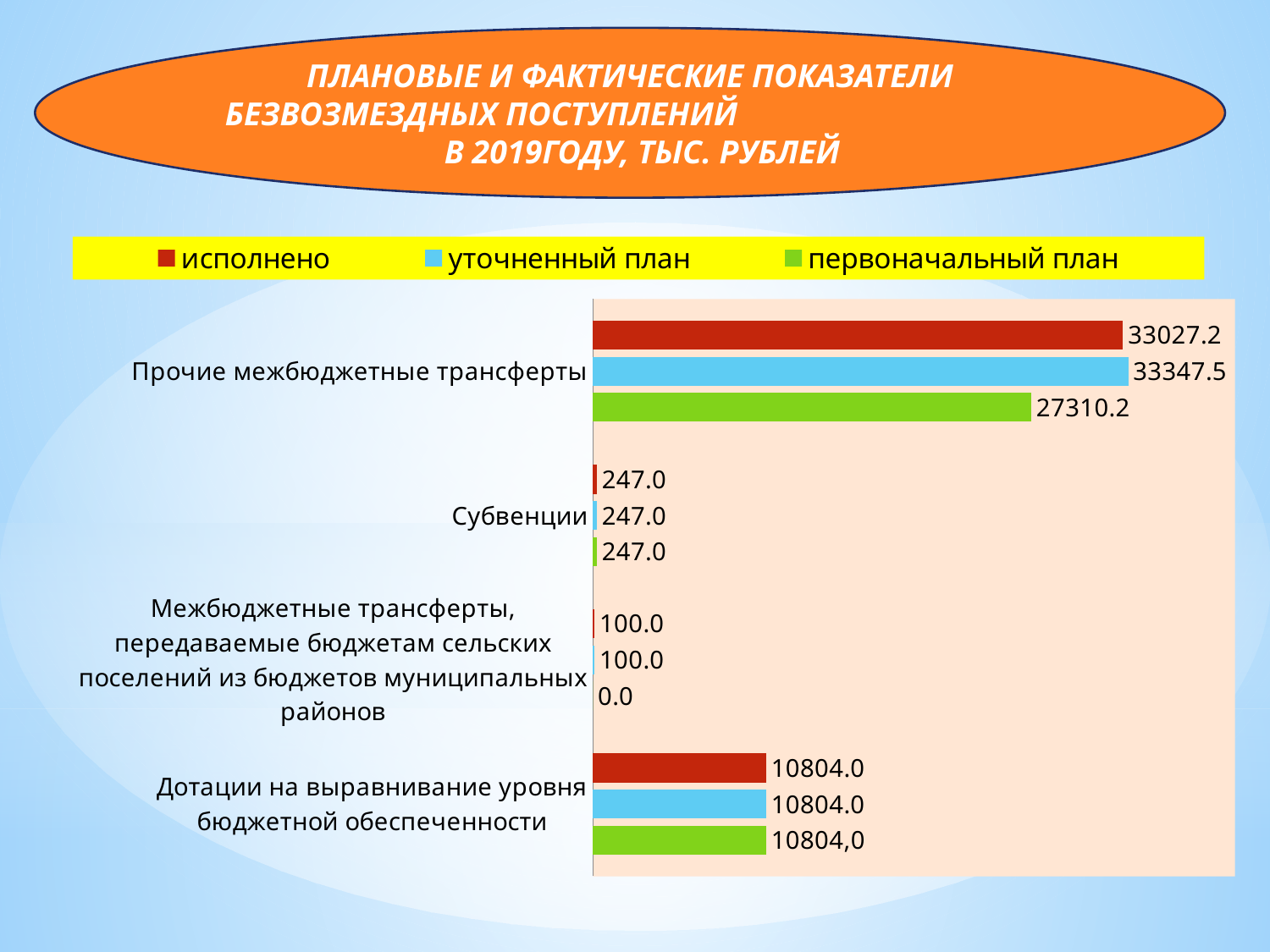
Which category has the lowest 'первоначальный план' value? Межбюджетные трансферты, передаваемые бюджетам сельских поселений из бюджетов муниципальных районов What type of chart is shown on the slide? bar chart What is the value of 'первоначальный план' for 'Прочие межбюджетные трансферты'? 27310.2 How many series does the legend list? 3 What is the value of 'первоначальный план' for 'Межбюджетные трансферты, передаваемые бюджетам сельских поселений из бюджетов муниципальных районов'? 0.0 What is the difference between 'уточненный план' and 'первоначальный план' for 'Прочие межбюджетные трансферты'? 6037.3 How many categories are shown on the chart? 4 What is the value of 'исполнено' for 'Дотации на выравнивание уровня бюджетной обеспеченности'? 10804.0 Which series is shown in red in the legend? исполнено What is the value of 'уточненный план' for 'Прочие межбюджетные трансферты'? 33347.5 Which category has the highest 'исполнено' value? Прочие межбюджетные трансферты What is the value of 'исполнено' for 'Прочие межбюджетные трансферты'? 33027.2